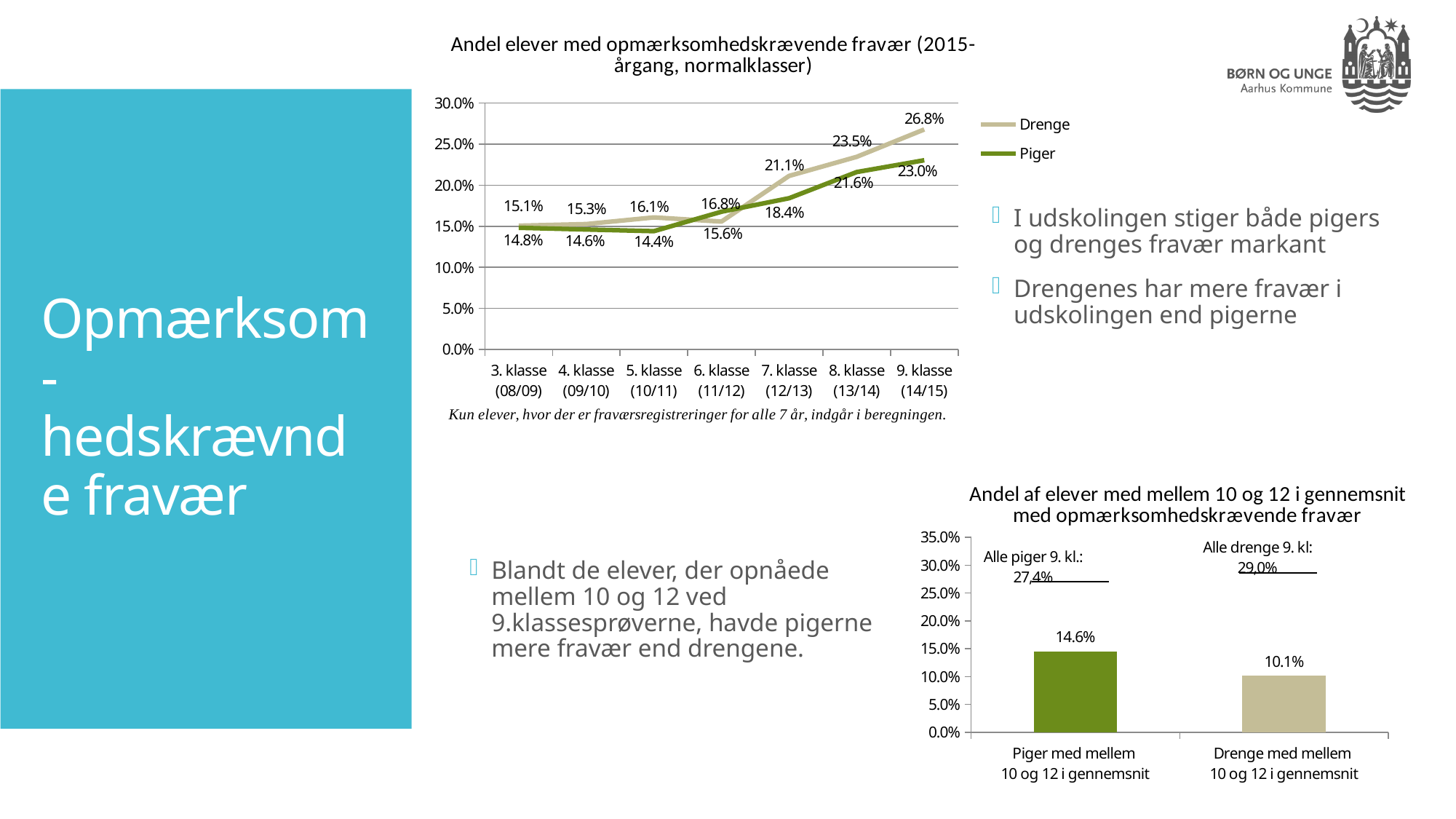
In the top line chart, in which grade is the Drenge value highest? 9. klasse (14/15) In the top line chart, how many series does the legend list? 2 In the top line chart, what is the difference between Drenge and Piger in 9. klasse (14/15)? 3.8% In the top line chart, which series has the higher value in 6. klasse (11/12), Drenge or Piger? Piger In the top line chart, how many grade categories are shown on the x axis? 7 In the bottom bar chart, what is the difference between the Piger bar and the Drenge bar? 4.5% In the top line chart, what is the value for Drenge in 9. klasse (14/15)? 26.8% In the bottom bar chart, what is the value for Piger med mellem 10 og 12 i gennemsnit? 14.6% In the top line chart, does the Drenge series generally rise or fall from 3. klasse to 9. klasse? rise In the top line chart, in which grade is the Piger value lowest? 5. klasse (10/11) In the top line chart, what is the value for Piger in 5. klasse (10/11)? 14.4% In the top line chart, what is the value for Piger in 7. klasse (12/13)? 18.4%